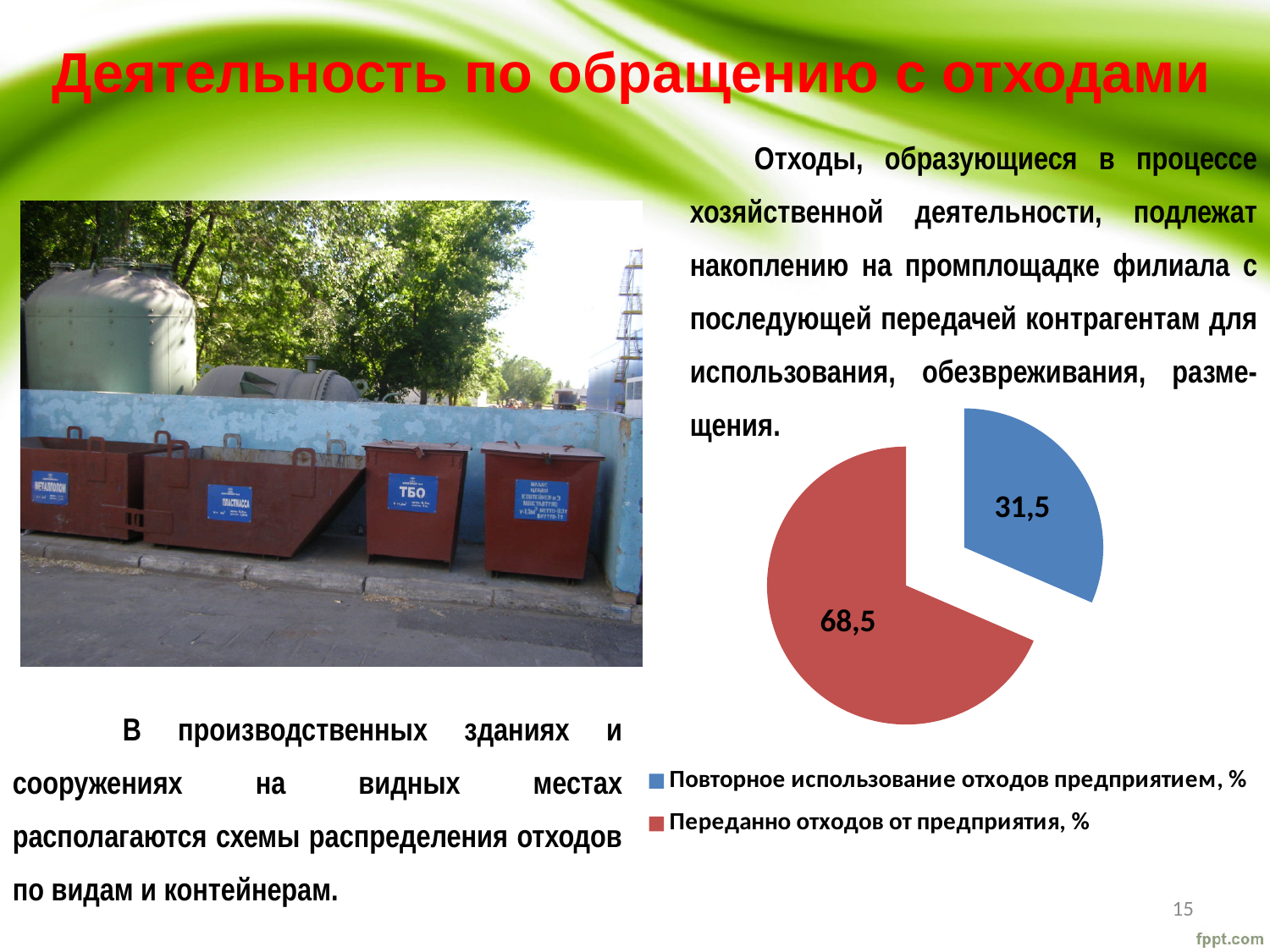
What colour is the slice for "Переданно отходов от предприятия, %" in the pie chart? red What colour is the slice for "Повторное использование отходов предприятием, %" in the pie chart? blue How many entries does the legend of the pie chart list? 2 What is the value for "Повторное использование отходов предприятием, %" in the pie chart? 31,5 Which category has the smallest slice in the pie chart? Повторное использование отходов предприятием, % What is the value for "Переданно отходов от предприятия, %" in the pie chart? 68,5 What is the total of the two values shown in the pie chart? 100 Which is larger: "Повторное использование отходов предприятием, %" or "Переданно отходов от предприятия, %"? Переданно отходов от предприятия, % Which category has the largest slice in the pie chart? Переданно отходов от предприятия, % What is the difference between the two slices of the pie chart? 37 What kind of chart is shown on the slide? pie chart How many slices does the pie chart have? 2